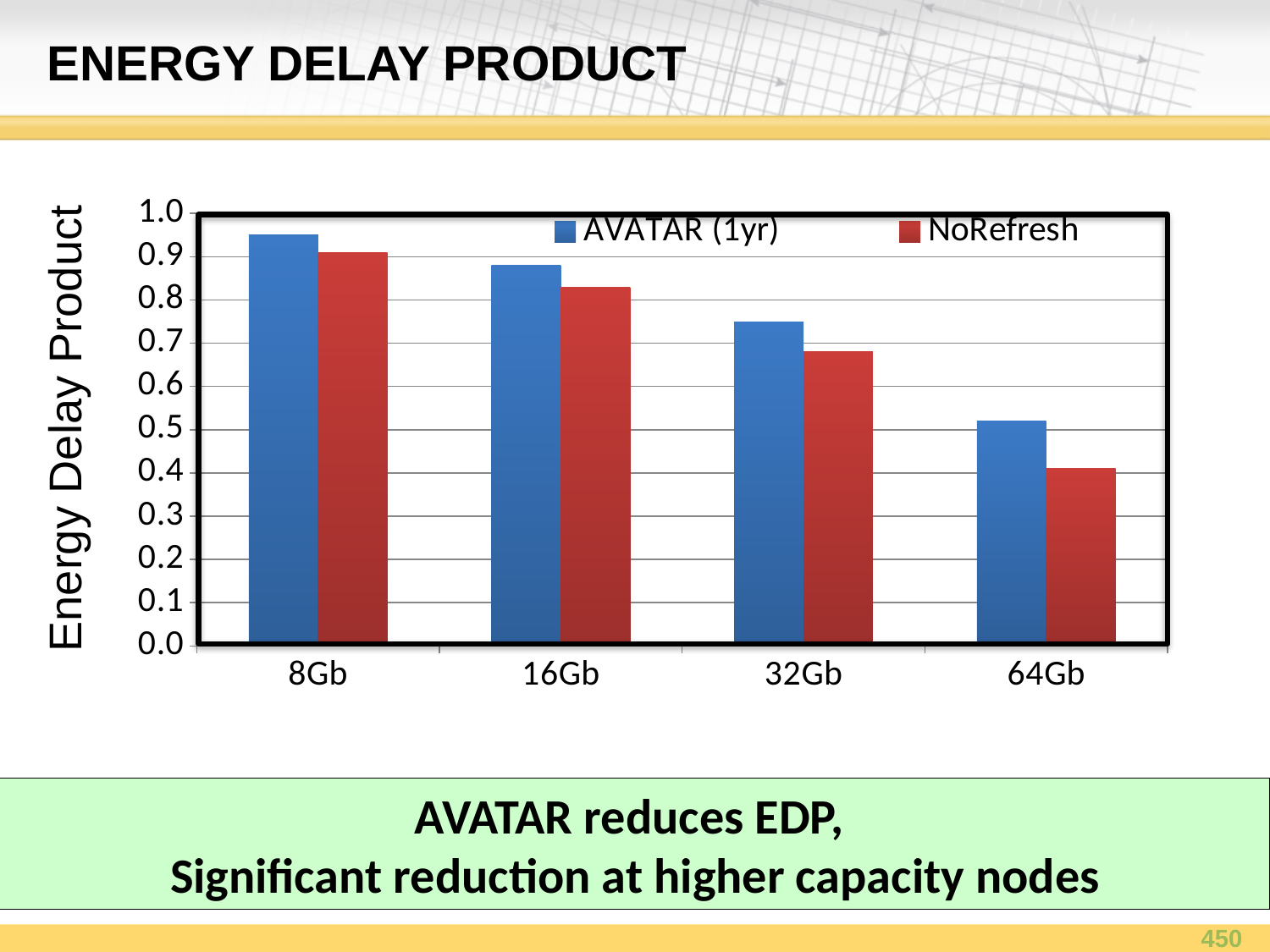
Is the NoRefresh value for 8Gb greater or less than 0.8? greater What is the label on the y axis? Energy Delay Product Which capacity has the lowest NoRefresh value? 64Gb How many capacity categories are shown on the x axis? 4 Is the NoRefresh value for 64Gb greater or less than 0.5? less Which capacity has the highest AVATAR (1yr) value? 8Gb How many series does the legend list? 2 What kind of chart is shown on the slide? bar chart At 64Gb, which series has the larger value, AVATAR (1yr) or NoRefresh? AVATAR (1yr) Is the AVATAR (1yr) value for 32Gb greater or less than 0.7? greater Do the NoRefresh values rise or fall as capacity increases from 8Gb to 64Gb? fall